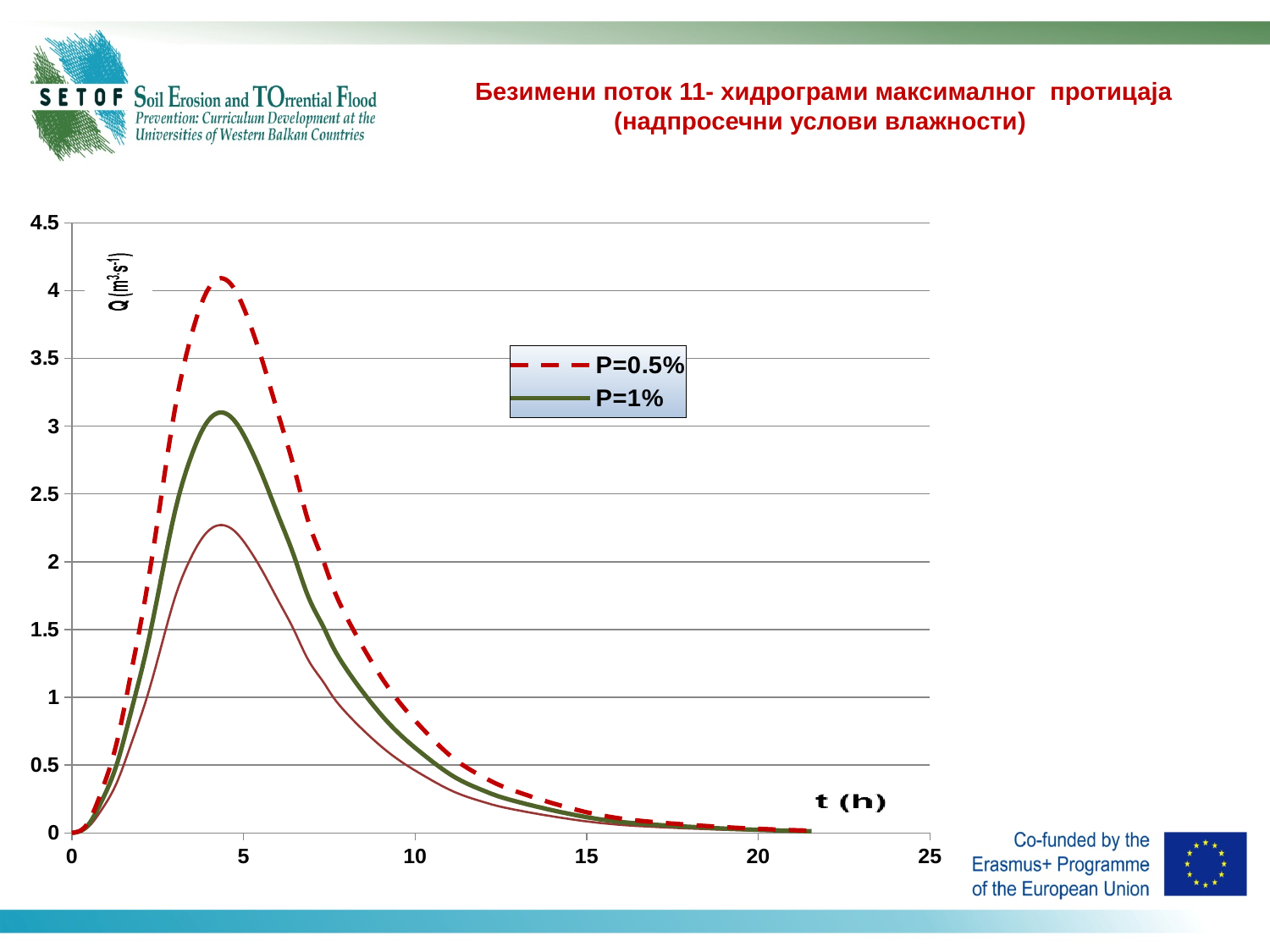
Is the peak value of the P=0.5% curve greater or less than 3.5? greater Which series reaches the higher peak discharge, P=0.5% or P=1%? P=0.5% Is the value of the P=1% curve at t = 15 h greater or less than 0.5? less What kind of chart is shown on the slide? line chart Is the value of the P=0.5% curve at t = 10 h greater or less than 1.5? less How many series does the legend list? 2 What is the label of the x axis? t (h) Which line style is used for the P=0.5% series in the legend? dashed red line After reaching their peaks, do the curves rise or fall as t increases? fall